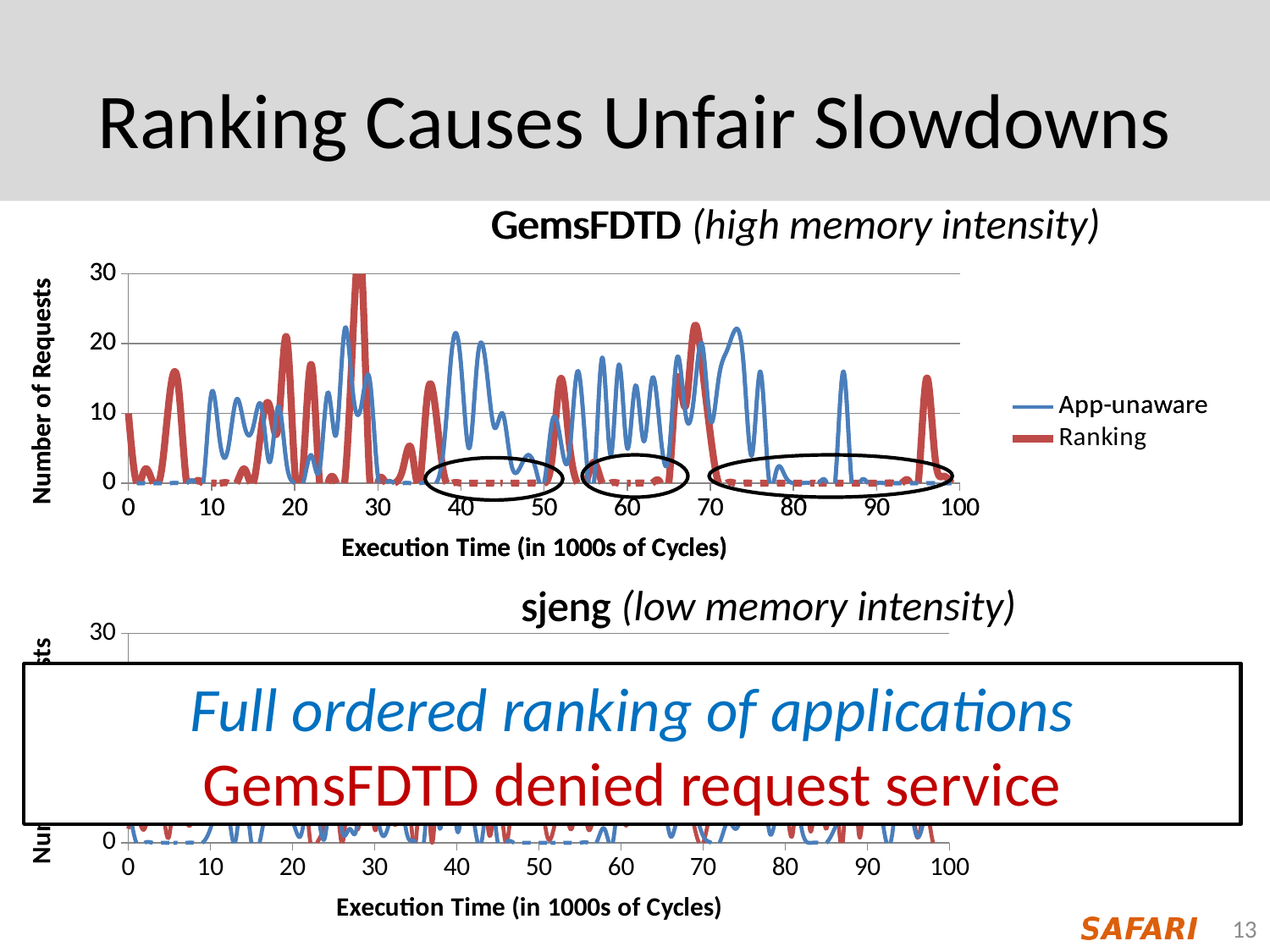
How many series does the legend of the GemsFDTD (high memory intensity) chart list? 2 What kind of chart is the GemsFDTD (high memory intensity) chart? line chart In the GemsFDTD (high memory intensity) chart, is the Ranking value at execution time 45 greater or less than 10? less In the GemsFDTD (high memory intensity) chart, is the App-unaware value at execution time 40 greater or less than 10? greater In the GemsFDTD (high memory intensity) chart, which series has the higher value at execution time 73, App-unaware or Ranking? App-unaware In the GemsFDTD (high memory intensity) chart, which series has the higher value at execution time 28, App-unaware or Ranking? Ranking In the GemsFDTD (high memory intensity) chart, is the peak Ranking value near execution time 28 greater or less than 20? greater What is the x-axis title of the GemsFDTD (high memory intensity) chart? Execution Time (in 1000s of Cycles) What are the two series named in the legend of the GemsFDTD (high memory intensity) chart? App-unaware and Ranking